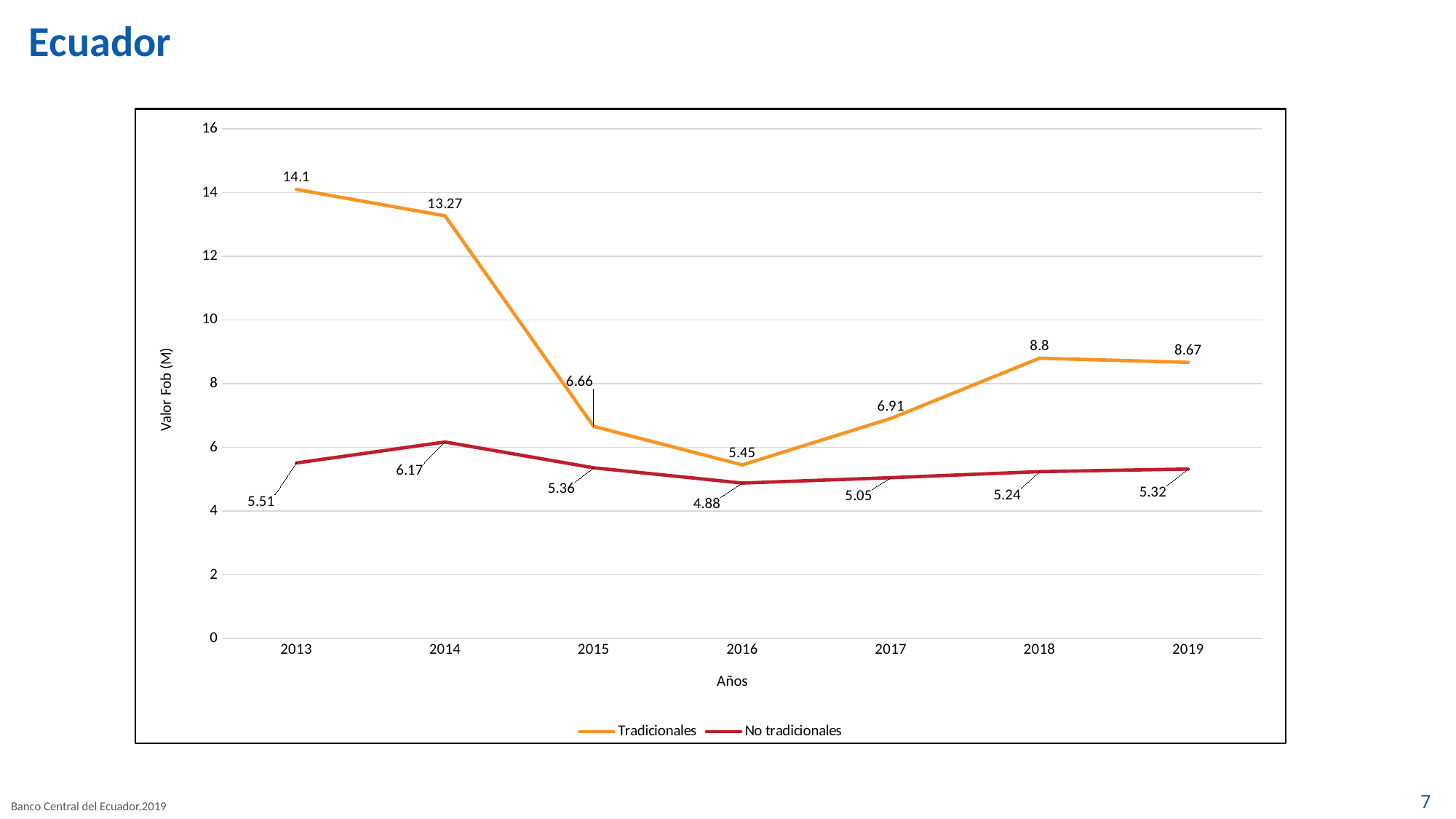
How many series does the legend list? 2 What is the difference between Tradicionales and No tradicionales in 2019? 3.35 Which series has the larger value in 2015, Tradicionales or No tradicionales? Tradicionales How many years are shown on the x axis? 7 Is the value for Tradicionales in 2014 greater or less than 12? greater In which year is the Tradicionales series at its lowest? 2016 What is the value for Tradicionales in 2013? 14.1 What is the value for Tradicionales in 2018? 8.8 In which year is the No tradicionales series at its highest? 2014 What is the value for No tradicionales in 2016? 4.88 What kind of chart is shown on the slide? Line chart What is the label of the y axis? Valor Fob (M)